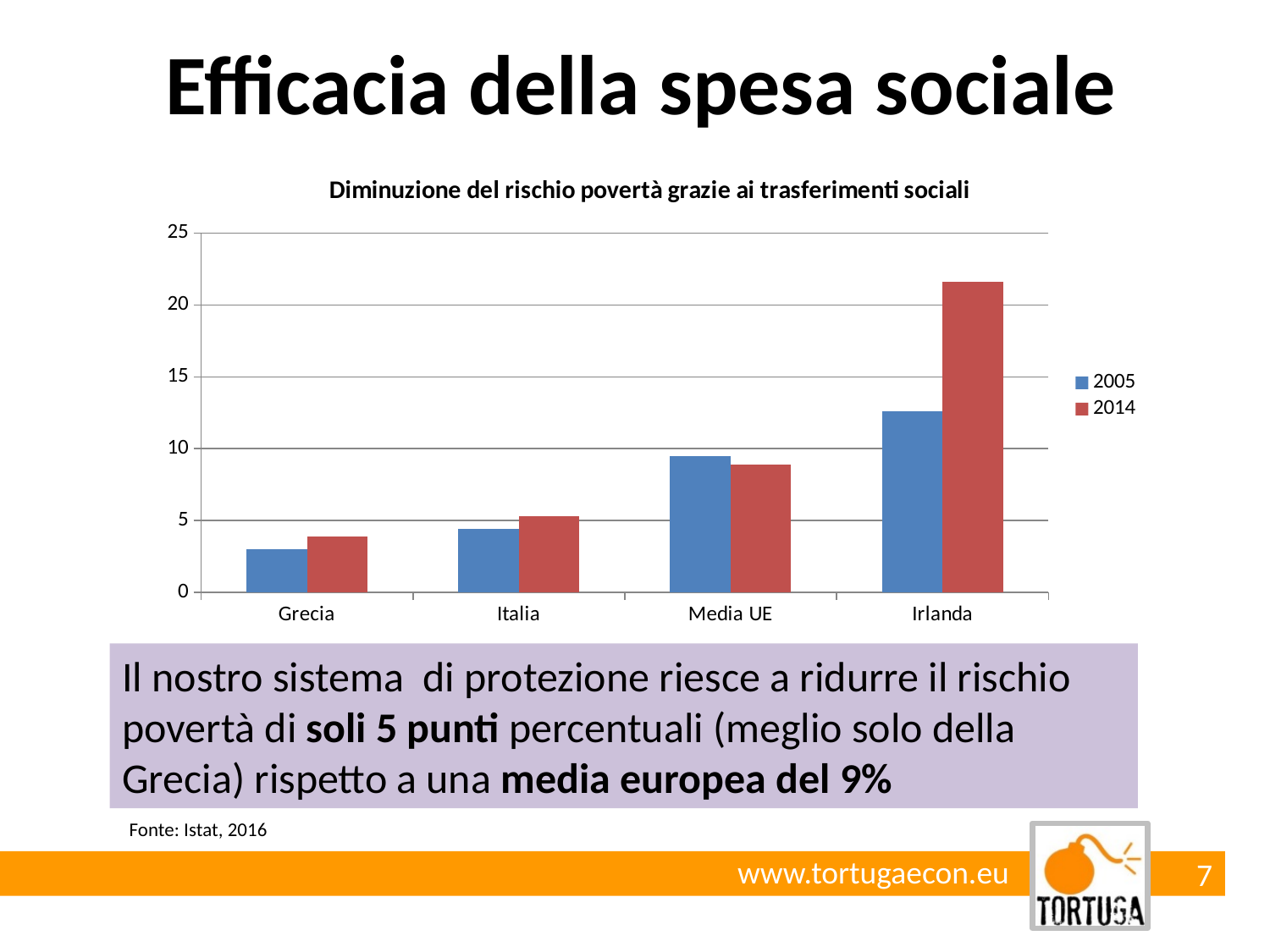
Which category has the lowest value for 2005? Grecia Which is larger: the 2014 value for Italia or the 2014 value for Grecia? Italia How many series does the legend list? 2 Which category has the highest value for 2014? Irlanda Is the value for Irlanda in 2005 greater or less than 10? greater Is the value for Italia in 2014 greater or less than 10? less How many categories are shown on the x axis? 4 What is the title of the chart? Diminuzione del rischio povertà grazie ai trasferimenti sociali What type of chart is shown on the slide? bar chart Which series is shown in red? 2014 Is the value for Irlanda in 2014 greater or less than 20? greater Which is larger for Media UE: the 2005 value or the 2014 value? 2005